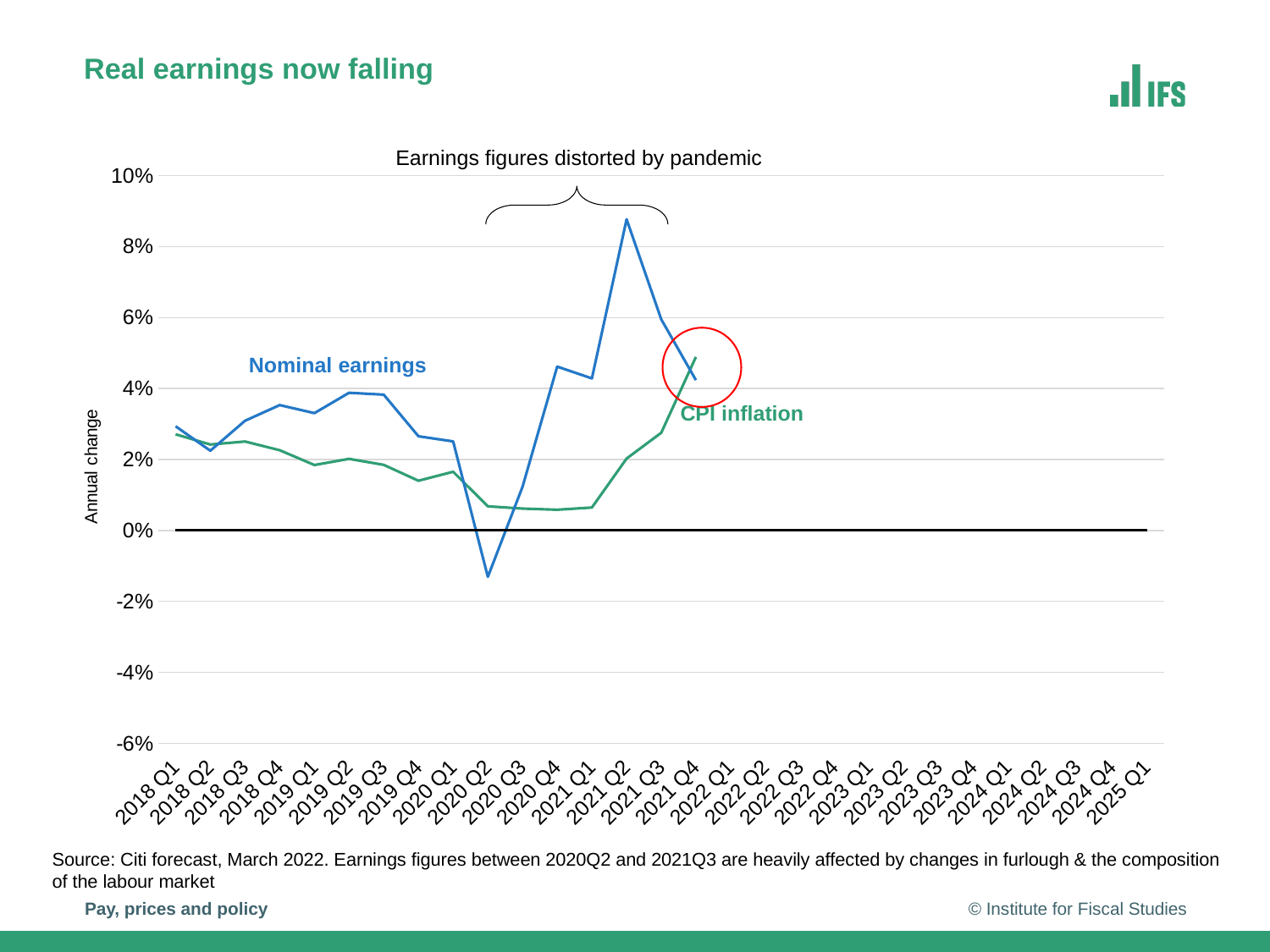
In which quarter does Nominal earnings reach its lowest value? 2020 Q2 Does CPI inflation rise or fall between 2021 Q1 and 2021 Q4? rise How many data series are plotted on the chart? 2 What kind of chart is shown on the slide? line chart In 2021 Q2, which series has the higher value, Nominal earnings or CPI inflation? Nominal earnings Is the value for CPI inflation in 2020 Q3 greater or less than 2%? less Is the value for Nominal earnings in 2021 Q2 greater or less than 8%? greater Is the value for CPI inflation in 2021 Q4 greater or less than 4%? greater In which quarter does Nominal earnings reach its highest value? 2021 Q2 What is the label on the vertical axis? Annual change